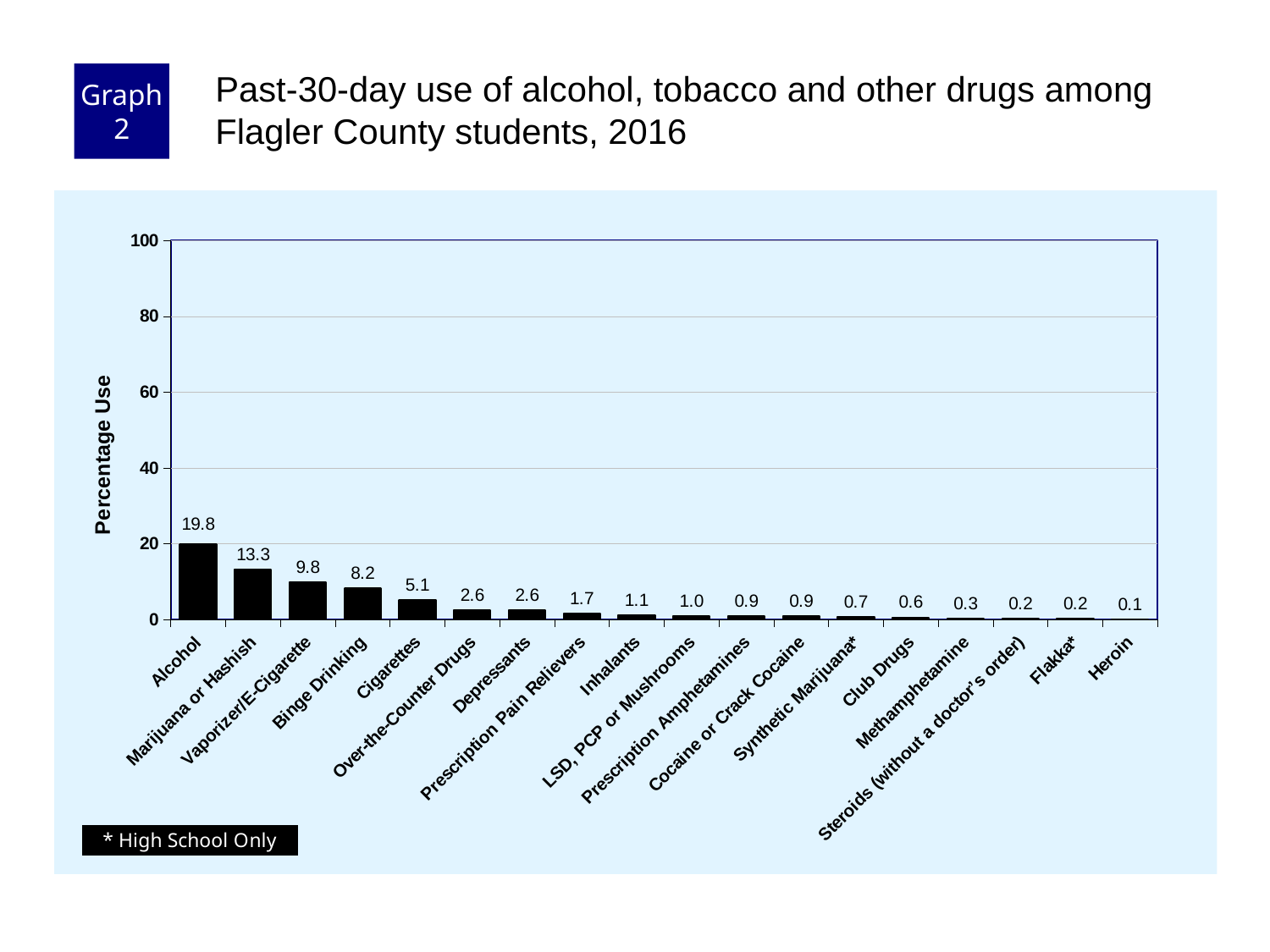
What is the difference in percentage use between Alcohol and Marijuana or Hashish? 6.5 Which category has the highest percentage use? Alcohol Which category has the lowest percentage use? Heroin Is the value for Alcohol greater or less than 20? less What is the label of the y axis? Percentage Use What is the percentage use for Alcohol? 19.8 What is the percentage use for Vaporizer/E-Cigarette? 9.8 Which has a higher percentage use, Binge Drinking or Cigarettes? Binge Drinking What kind of chart is shown on the slide? bar chart What is the percentage use for Cigarettes? 5.1 What is the percentage use for Methamphetamine? 0.3 How many categories are shown on the x axis? 18